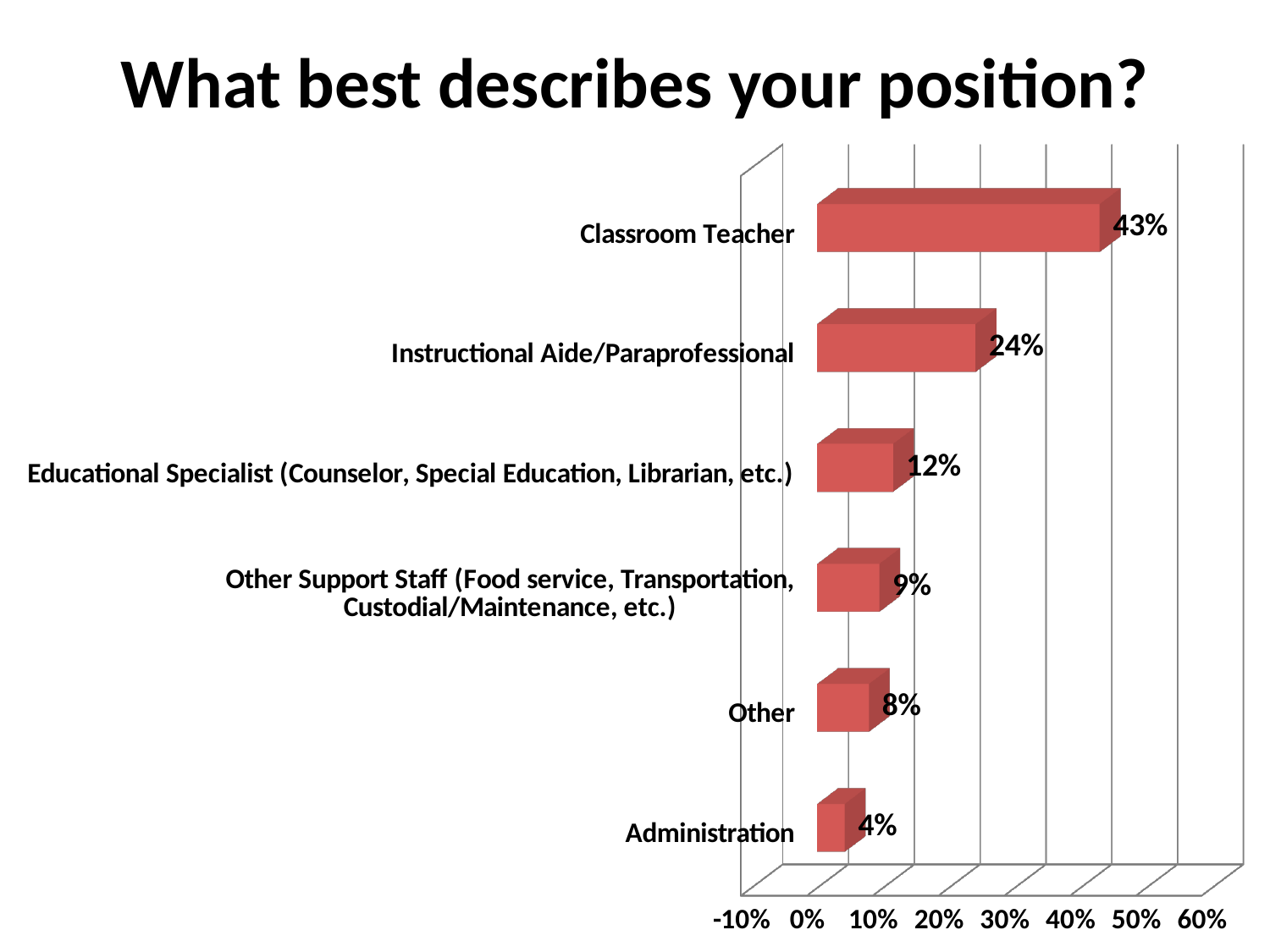
What is the title of the chart? What best describes your position? How many position categories are shown in the chart? 6 Which position category has the highest value? Classroom Teacher What is the value for Administration? 4% What is the value for Instructional Aide/Paraprofessional? 24% Which position category has the lowest value? Administration What is the difference between the Classroom Teacher value and the Instructional Aide/Paraprofessional value? 19% Is the value for Classroom Teacher greater or less than 40%? greater What is the value for Other? 8% What kind of chart is shown on the slide? Bar chart Which is larger, the value for Educational Specialist or the value for Other Support Staff? Educational Specialist What percentage of respondents are Classroom Teachers? 43%